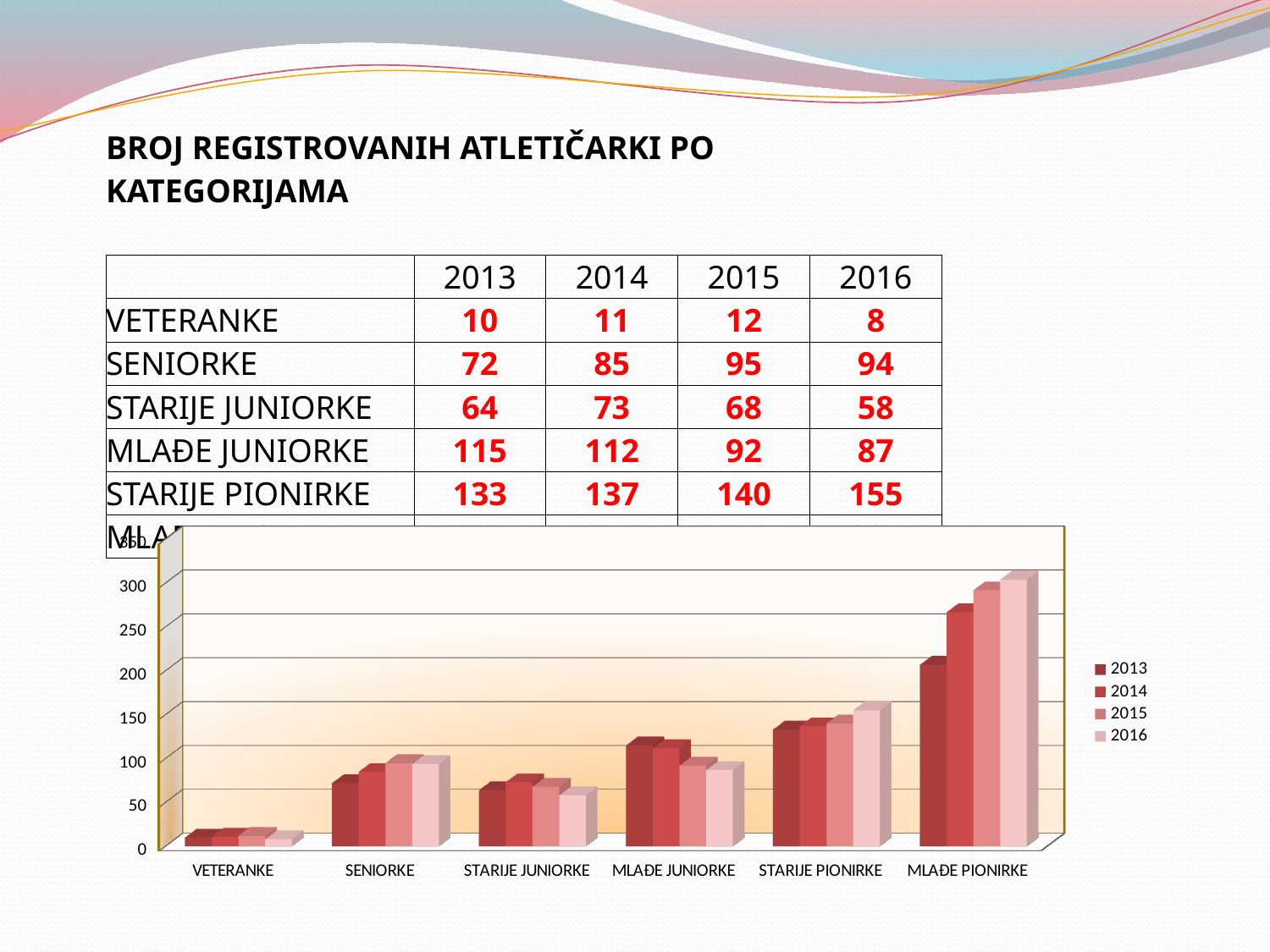
Which is larger in 2015: SENIORKE or STARIJE JUNIORKE? SENIORKE Which category has the highest value for 2016? MLAĐE PIONIRKE What is the value for SENIORKE in 2015? 95 Which category has the lowest value for 2013? VETERANKE Is the value for MLAĐE PIONIRKE in 2016 greater or less than 250? greater What kind of chart is shown on the slide? bar chart What is the title of the slide above the chart? BROJ REGISTROVANIH ATLETIČARKI PO KATEGORIJAMA How many series does the chart legend list? 4 Do the values for MLAĐE JUNIORKE rise or fall from 2013 to 2016? fall What is the difference between the SENIORKE values for 2015 and 2013? 23 What is the value for STARIJE PIONIRKE in 2016? 155 How many categories are shown along the x axis of the chart? 6